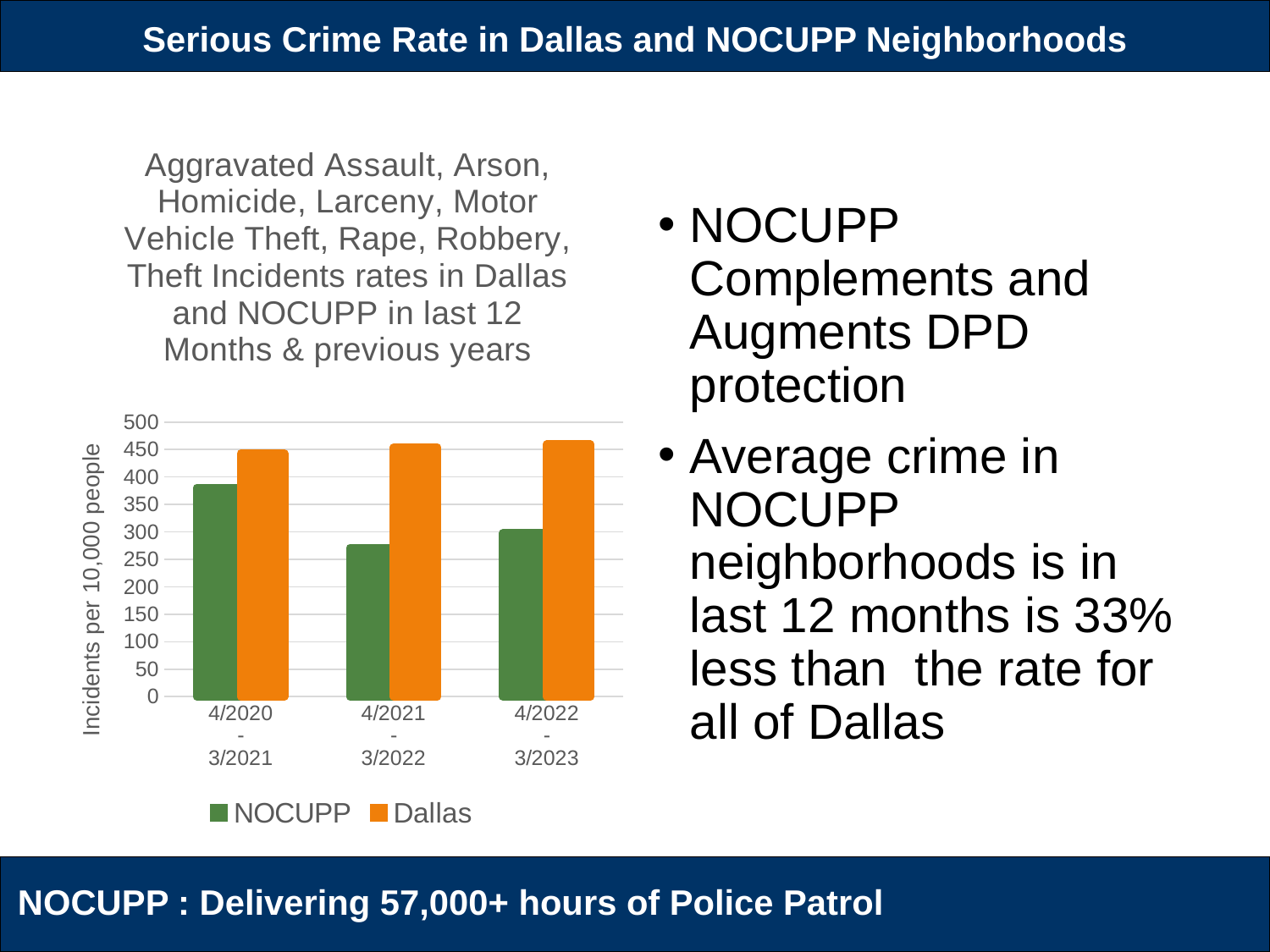
Do the Dallas values rise or fall across the three periods from left to right? rise How many series does the chart legend list? 2 Which is larger for 4/2022 - 3/2023, the NOCUPP value or the Dallas value? Dallas Is the NOCUPP value for 4/2021 - 3/2022 greater or less than 300? less What kind of chart is shown on the slide? bar chart Is the Dallas value for 4/2022 - 3/2023 greater or less than 400? greater How many time periods are shown on the x axis of the chart? 3 Which series is shown in orange in the chart? Dallas Is the NOCUPP value for 4/2020 - 3/2021 greater or less than 350? greater In which period is the NOCUPP value lowest? 4/2021 - 3/2022 In which period is the NOCUPP value highest? 4/2020 - 3/2021 What is the label on the vertical axis of the chart? Incidents per 10,000 people